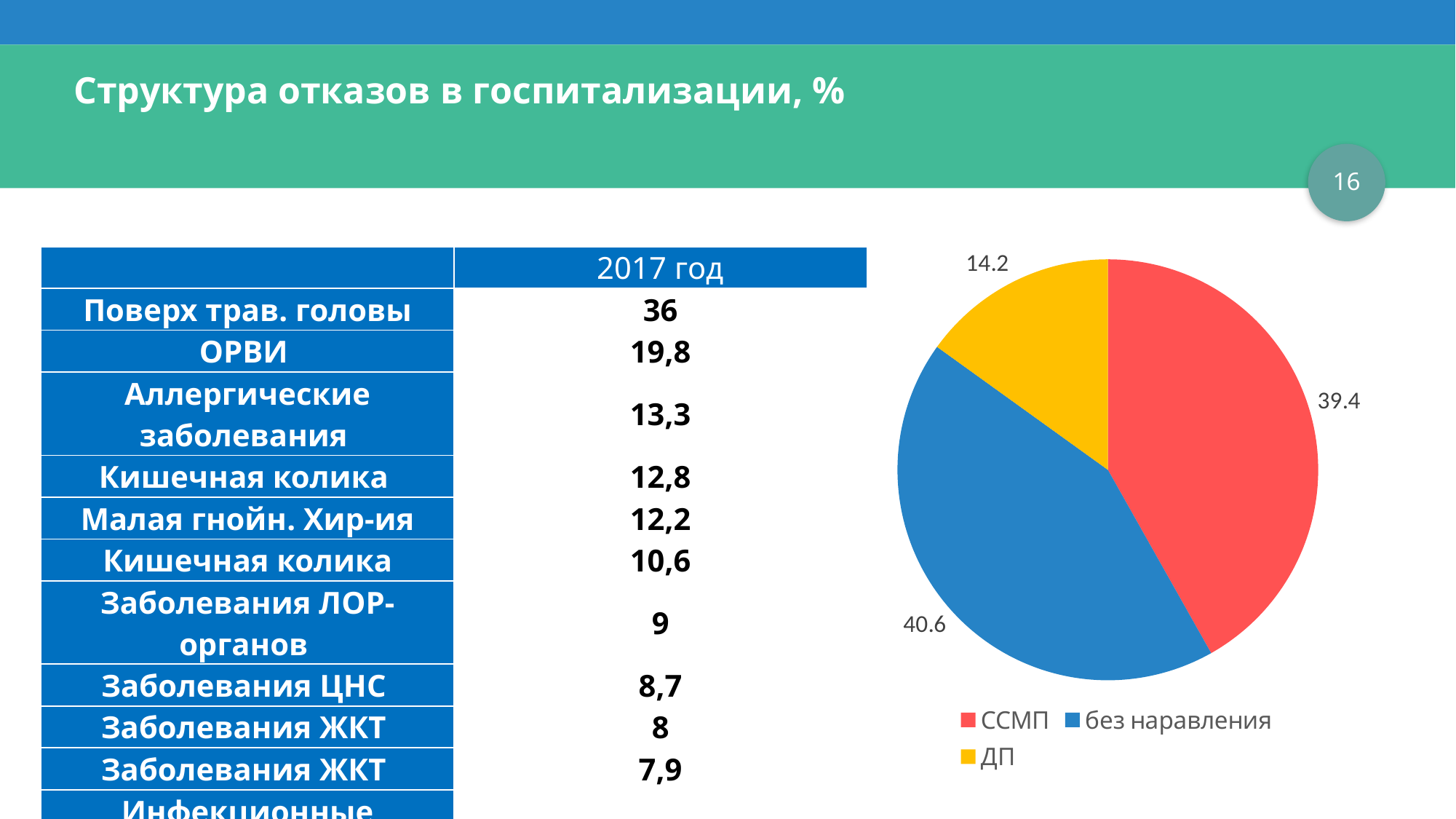
How many slices does the pie chart have? 3 What is the value shown for the ССМП slice in the pie chart? 39.4 What is the value shown for the без наравления slice in the pie chart? 40.6 What is the difference between the без наравления value and the ССМП value in the pie chart? 1.2 Which slice of the pie chart has the largest value? без наравления How many entries does the legend of the pie chart list? 3 In the pie chart, which is larger: the value for ССМП or the value for ДП? ССМП What kind of chart is shown on the right side of the slide? Pie chart What colour is the ДП slice in the pie chart? Yellow Which slice of the pie chart has the smallest value? ДП What is the value shown for the ДП slice in the pie chart? 14.2 What is the difference between the ССМП value and the ДП value in the pie chart? 25.2